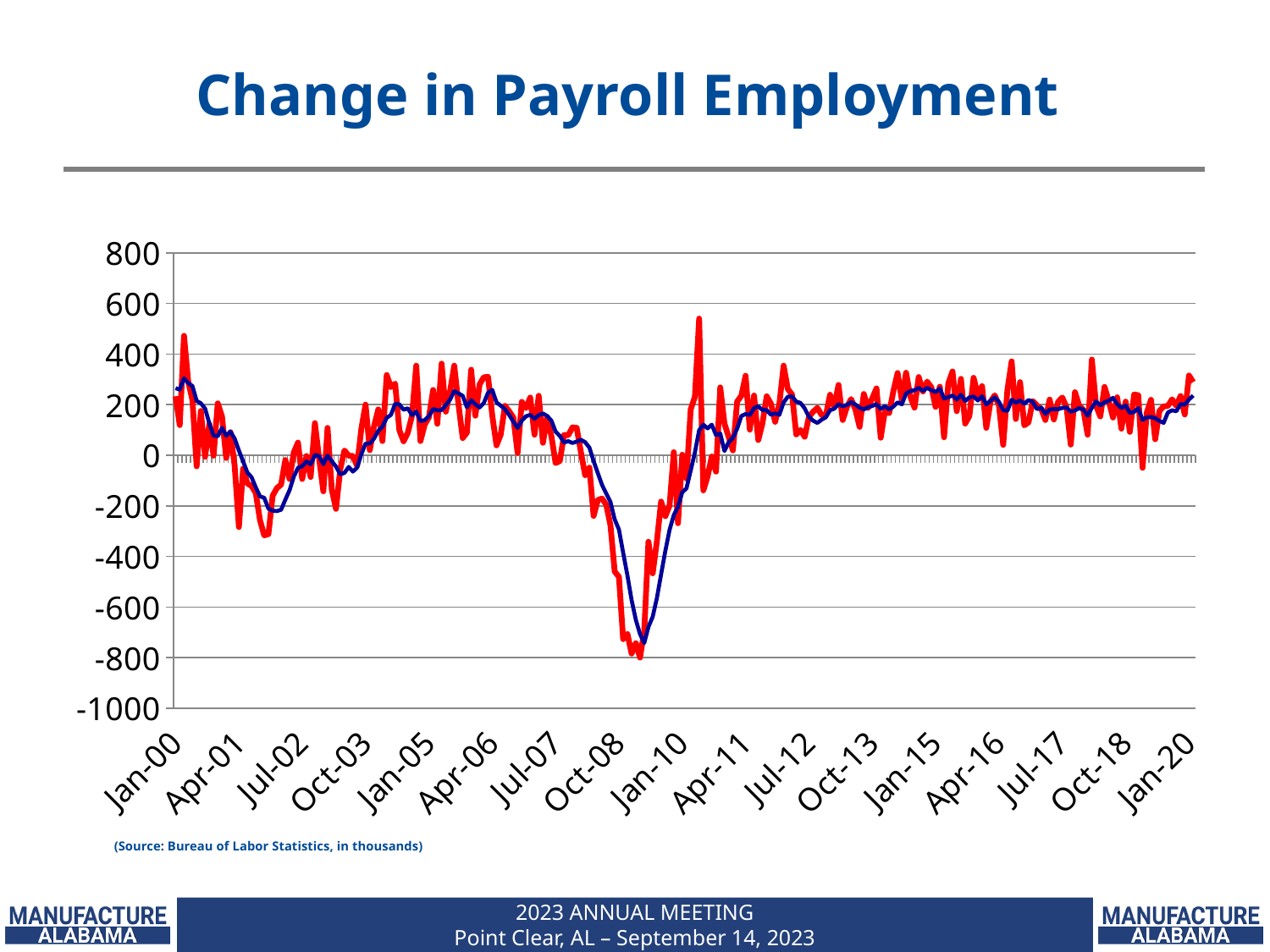
How many labels are shown on the x axis? 17 Between Jan-10 and Apr-11, do the values generally rise or fall? rise What is the title of the chart? Change in Payroll Employment What is the highest value shown on the y axis? 800 Between which two x-axis labels does the lowest point of the chart occur? Oct-08 and Jan-10 What colours are the two lines on the chart? red and blue What kind of chart is shown on the slide? line chart How many lines are plotted on the chart? 2 Between Jan-00 and Jul-02, do the values generally rise or fall? fall What is the lowest value shown on the y axis? -1000 Is the highest point of the red line greater or less than 400? greater Is the lowest point of the red line greater or less than -600? less